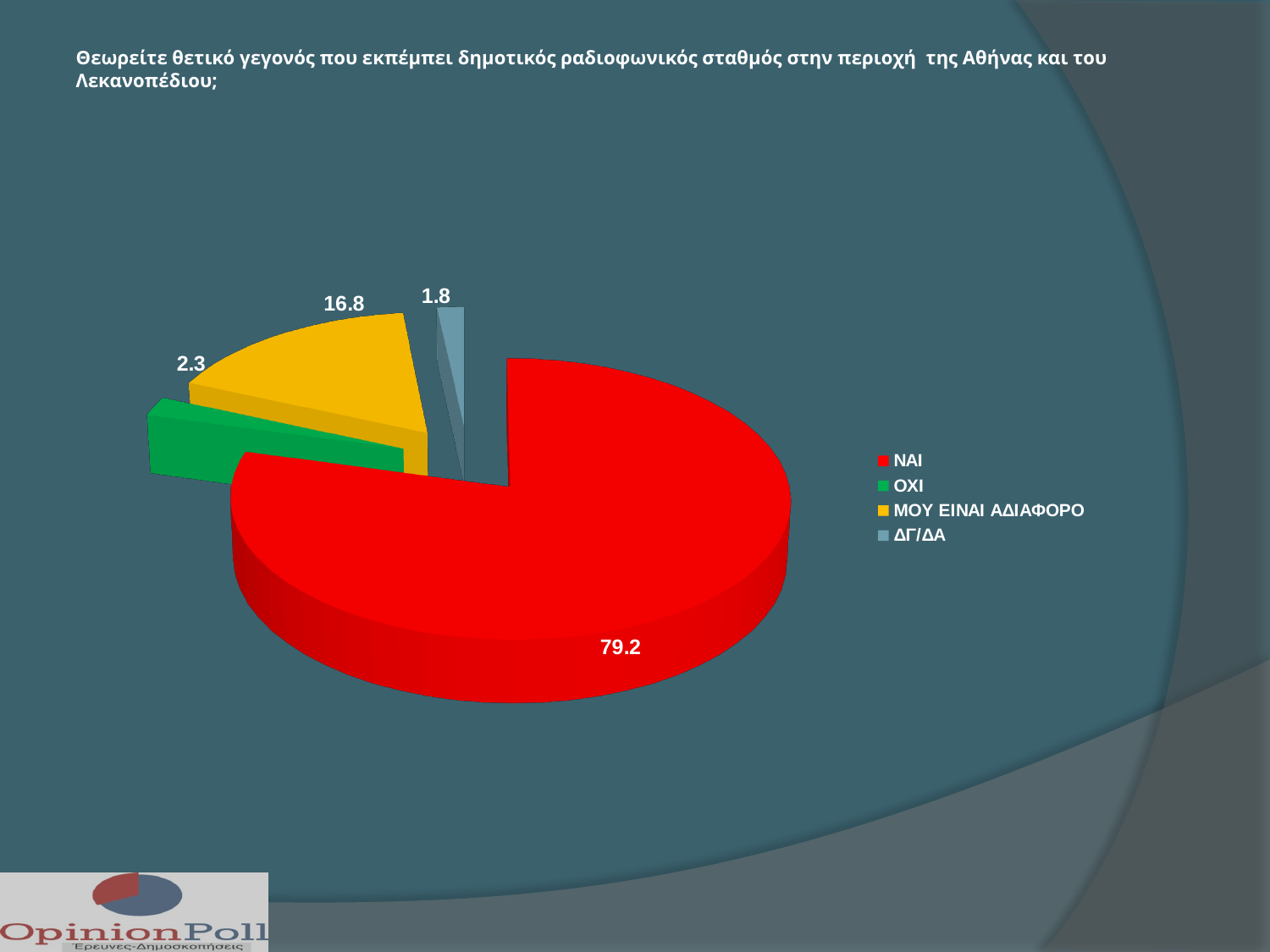
Which category has the largest slice? ΝΑΙ How many categories does the legend list? 4 Which is larger, the value for ΟΧΙ or the value for ΔΓ/ΔΑ? ΟΧΙ What colour is the slice for ΜΟΥ ΕΙΝΑΙ ΑΔΙΑΦΟΡΟ? Yellow What is the value for ΔΓ/ΔΑ? 1.8 What is the value for ΟΧΙ? 2.3 What colour is the slice for ΝΑΙ? Red What type of chart is shown on the slide? Pie chart What is the value for ΝΑΙ? 79.2 What is the difference between the values for ΝΑΙ and ΜΟΥ ΕΙΝΑΙ ΑΔΙΑΦΟΡΟ? 62.4 What is the value for ΜΟΥ ΕΙΝΑΙ ΑΔΙΑΦΟΡΟ? 16.8 Which category has the smallest slice? ΔΓ/ΔΑ